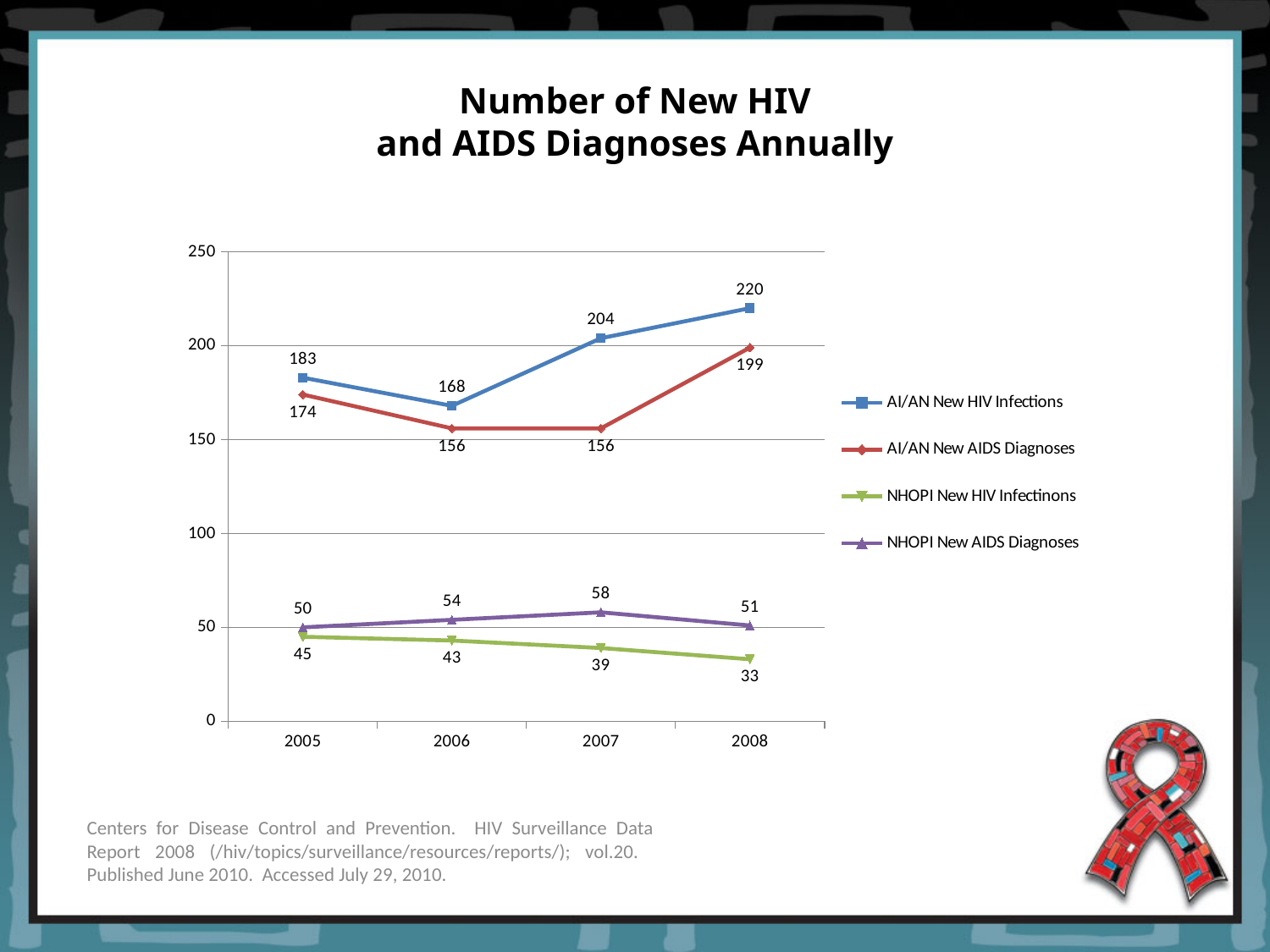
In which year is NHOPI New AIDS Diagnoses highest? 2007 Do the values for NHOPI New HIV Infectinons rise or fall from 2005 to 2008? fall What is the value for AI/AN New HIV Infections in 2008? 220 What is the value for AI/AN New AIDS Diagnoses in 2006? 156 How many years are shown on the x axis? 4 How many series does the legend list? 4 What is the difference between AI/AN New HIV Infections in 2008 and in 2005? 37 What is the value for NHOPI New HIV Infectinons in 2007? 39 Is the value for AI/AN New AIDS Diagnoses in 2008 greater or less than 150? greater In which year is AI/AN New HIV Infections lowest? 2006 Which is larger in 2005: AI/AN New HIV Infections or AI/AN New AIDS Diagnoses? AI/AN New HIV Infections What kind of chart is shown on the slide? line chart